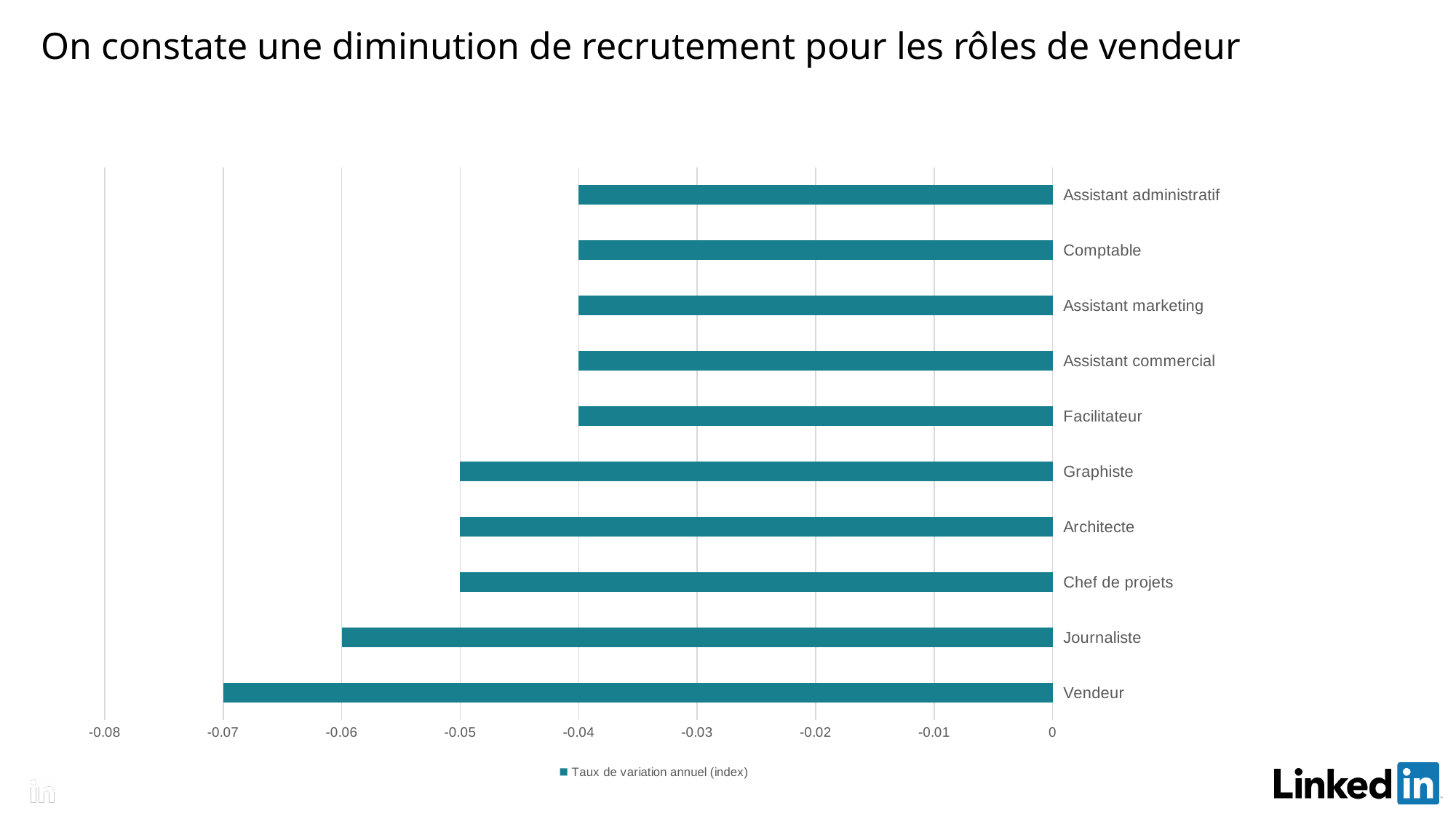
What is the name of the series shown in the legend? Taux de variation annuel (index) How many categories are shown in the chart? 10 What is the difference between the values for Assistant administratif and Chef de projets? 0.01 What is the value for Vendeur? -0.07 What is the value for Comptable? -0.04 What type of chart is shown on the slide? bar chart How many series does the legend list? 1 What is the value for Journaliste? -0.06 What is the difference between the values for Journaliste and Vendeur? 0.01 Which has the larger value, Architecte or Journaliste? Architecte Which category has the lowest value? Vendeur What is the value for Graphiste? -0.05